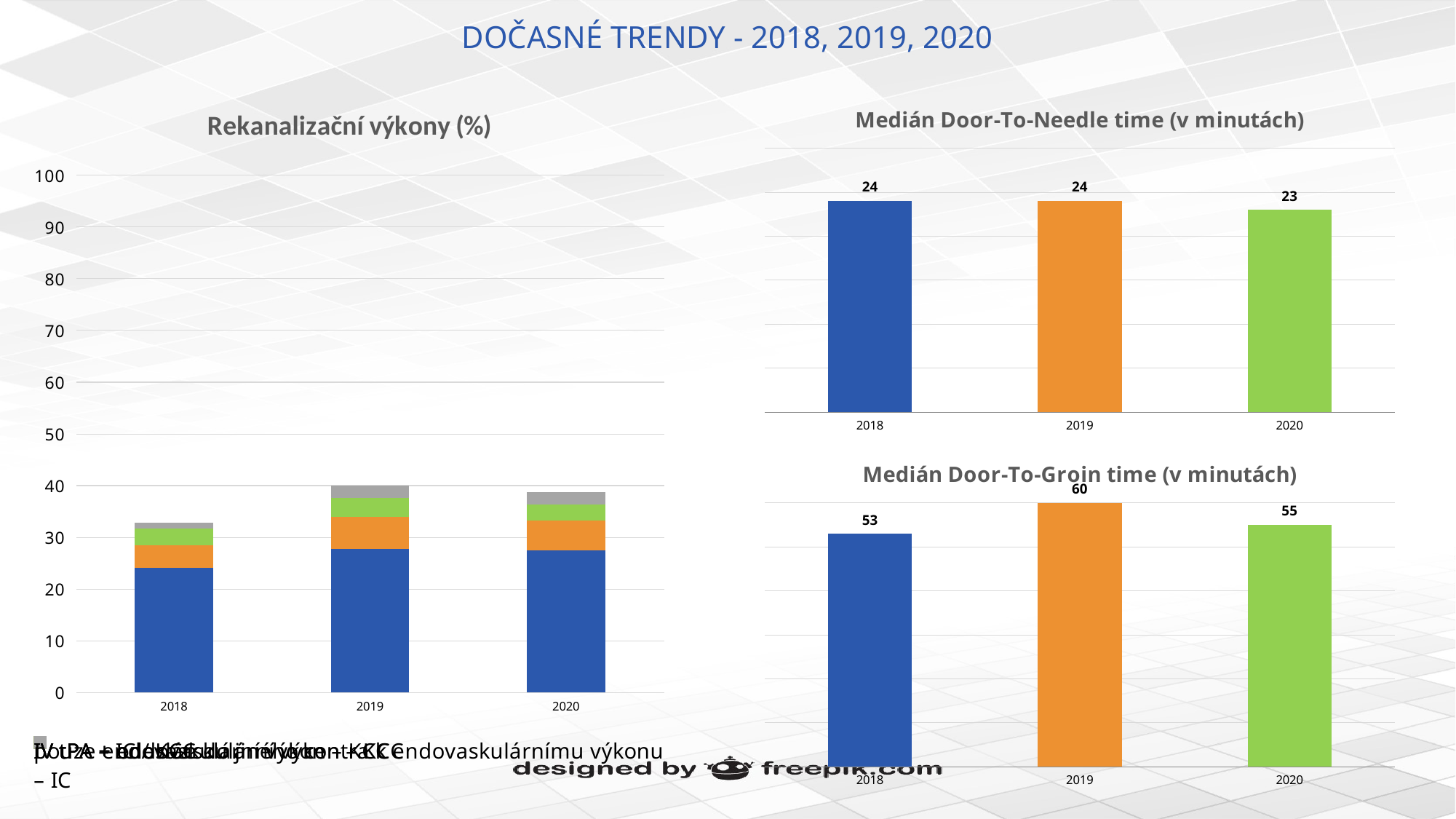
In the Medián Door-To-Needle time (v minutách) chart, what is the value for 2018? 24 In the Medián Door-To-Needle time (v minutách) chart, do the values rise or fall from 2019 to 2020? fall In the Medián Door-To-Groin time (v minutách) chart, which year has the highest value? 2019 In the Medián Door-To-Needle time (v minutách) chart, which is larger, the value for 2019 or the value for 2020? 2019 In the Rekanalizační výkony (%) chart, is the total height of the 2018 bar greater or less than 40? less In the Medián Door-To-Groin time (v minutách) chart, which year has the lowest value? 2018 In the Medián Door-To-Groin time (v minutách) chart, what is the difference between the 2019 and 2018 values? 7 What kind of chart is the Rekanalizační výkony (%) chart? Stacked bar chart In the Medián Door-To-Needle time (v minutách) chart, what is the value for 2020? 23 In the Medián Door-To-Groin time (v minutách) chart, what is the value for 2019? 60 In the Medián Door-To-Groin time (v minutách) chart, what is the value for 2020? 55 How many years are shown on the x axis of the Rekanalizační výkony (%) chart? 3